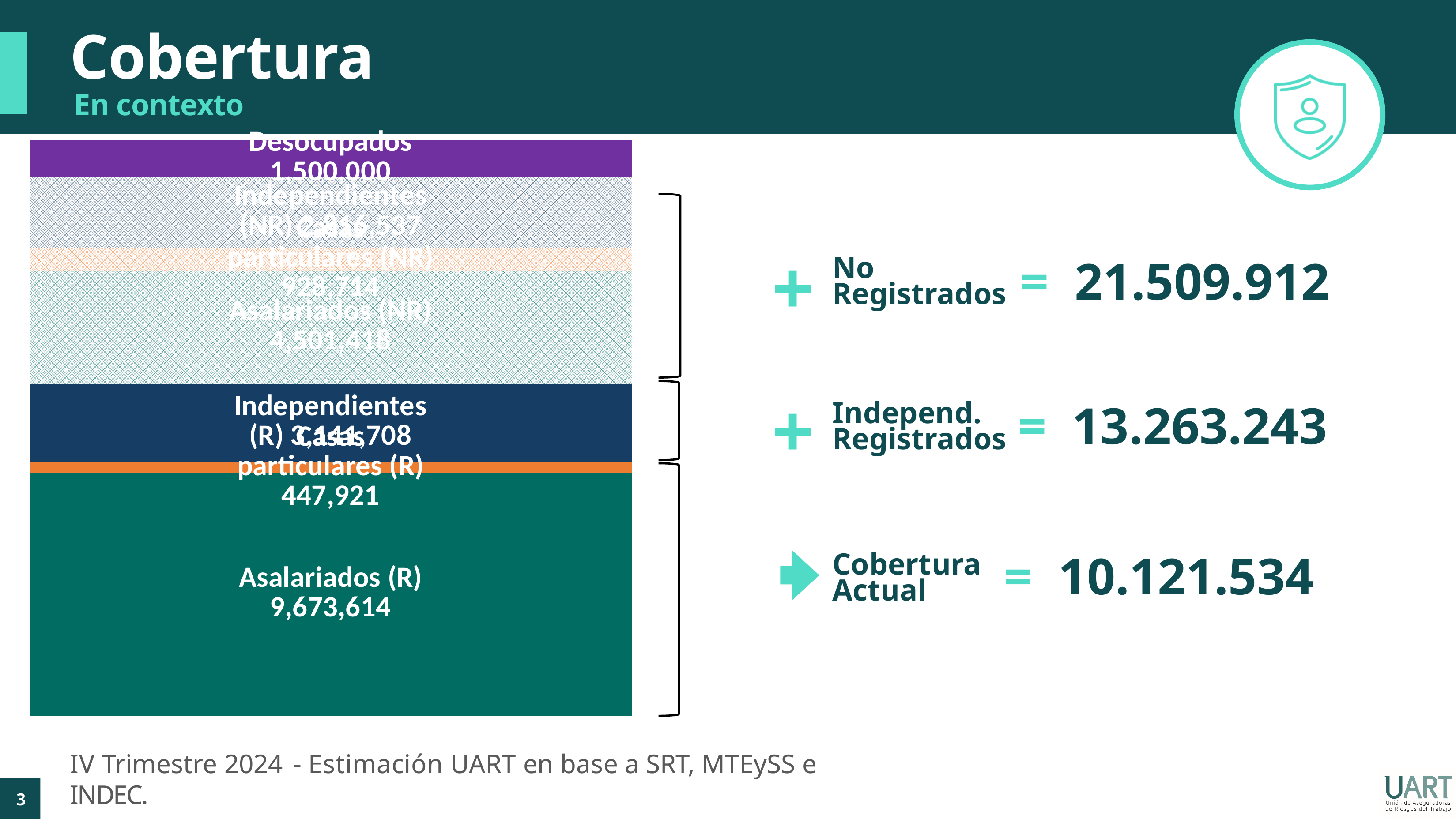
What is the value shown for Asalariados (R) in the stacked bar? 9,673,614 What is the value shown for Casas particulares (R)? 447,921 What is the value shown for Asalariados (NR) in the stacked bar? 4,501,418 What value is shown for the Desocupados segment at the top of the bar? 1,500,000 Which segment of the stacked bar has the smallest value? Casas particulares (R) What is the difference between Casas particulares (NR) and Casas particulares (R)? 480,793 How many segments make up the stacked bar? 7 Which segment of the stacked bar has the largest value? Asalariados (R) What kind of chart is shown on the left of the slide? Stacked bar chart What is the value shown for Casas particulares (NR)? 928,714 Which is larger, Asalariados (NR) or Desocupados? Asalariados (NR) What is the difference between Asalariados (R) and Asalariados (NR)? 5,172,196